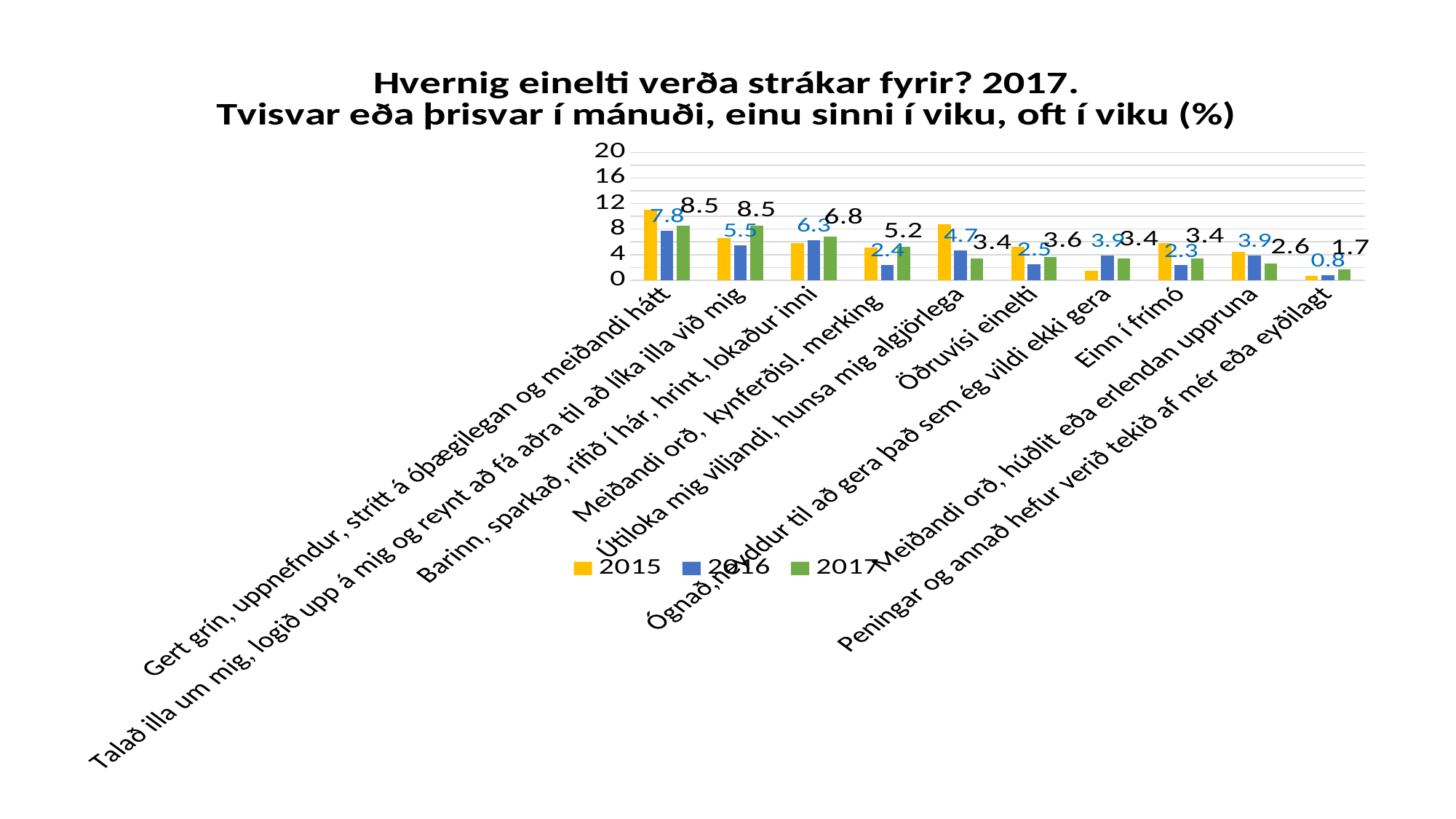
Is the 2015 value for "Gert grín, uppnefndur, strítt á óþægilegan og meiðandi hátt" greater or less than 8? greater Which colour represents the 2017 series in the legend? green What is the 2016 value for "Barinn, sparkað, rifið í hár, hrint, lokaður inni"? 6.3 What is the 2017 value for "Einn í frímó"? 3.4 Which category has the lowest 2017 value? Peningar og annað hefur verið tekið af mér eða eyðilagt What is the 2017 value for "Meiðandi orð, kynferðisl. merking"? 5.2 Which category has the highest 2016 value? Gert grín, uppnefndur, strítt á óþægilegan og meiðandi hátt What is the difference between the 2017 and 2016 values for "Meiðandi orð, kynferðisl. merking"? 2.8 What kind of chart is shown on the slide? bar chart How many categories are shown on the x axis? 10 How many series does the legend list? 3 For "Útiloka mig viljandi, hunsa mig algjörlega", which is larger: the 2016 value or the 2017 value? 2016